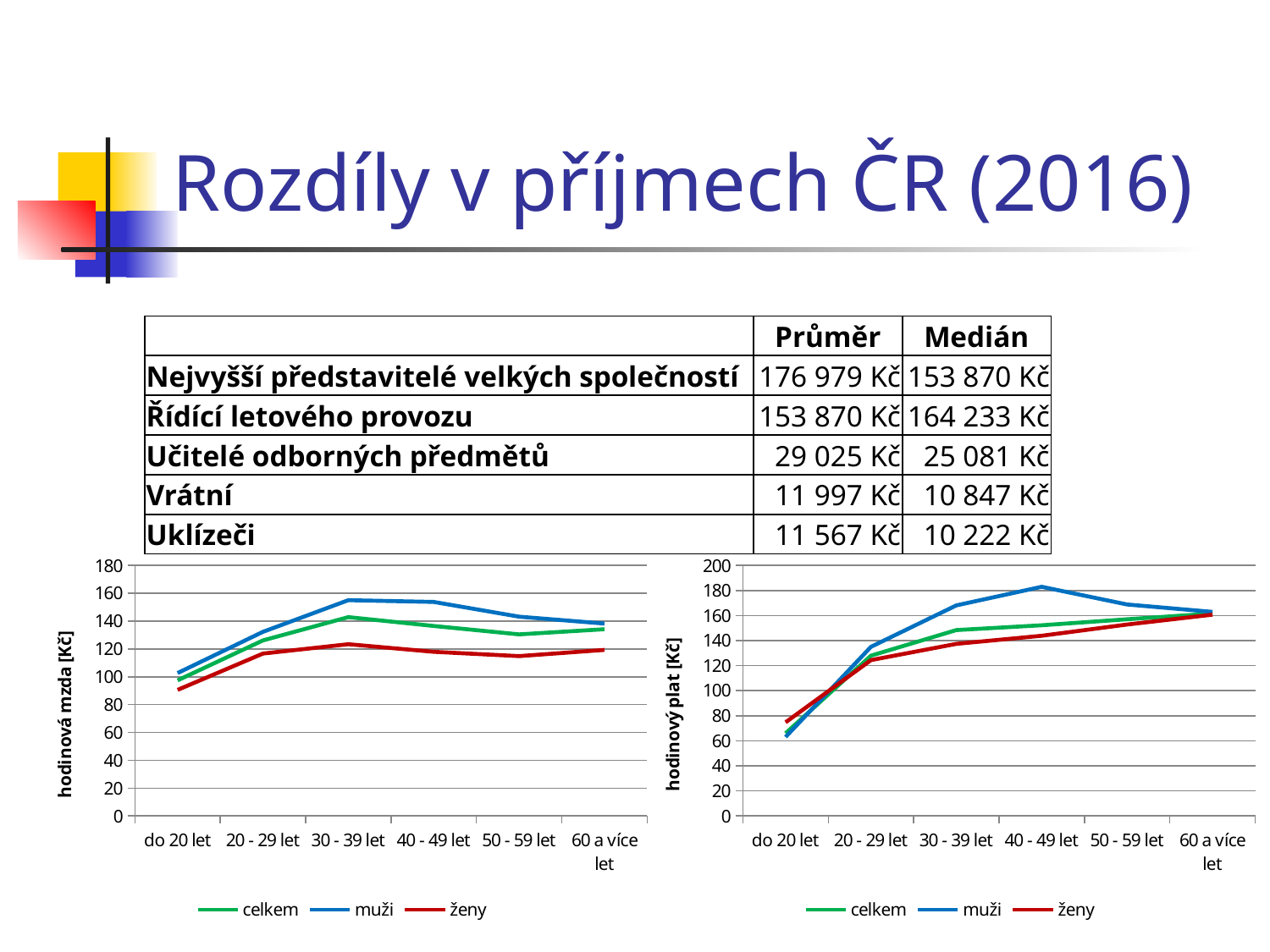
In the right chart (hodinový plat [Kč]), at 'do 20 let', which is larger: the value for muži or the value for ženy? ženy How many series does the legend of the left chart (hodinová mzda [Kč]) list? 3 In the left chart (hodinová mzda [Kč]), is the value for muži at '30 - 39 let' greater or less than 140? greater In the right chart (hodinový plat [Kč]), is the value for muži at '40 - 49 let' greater or less than 160? greater In the right chart (hodinový plat [Kč]), is the value for celkem at 'do 20 let' greater or less than 80? less In the left chart (hodinová mzda [Kč]), which age category has the lowest value for ženy? do 20 let In the right chart (hodinový plat [Kč]), do the values for ženy rise or fall from 'do 20 let' to '60 a více let'? rise What kind of chart is the left chart (hodinová mzda [Kč])? line chart How many age categories are shown on the x axis of the right chart (hodinový plat [Kč])? 6 In the right chart (hodinový plat [Kč]), which age category has the highest value for muži? 40 - 49 let